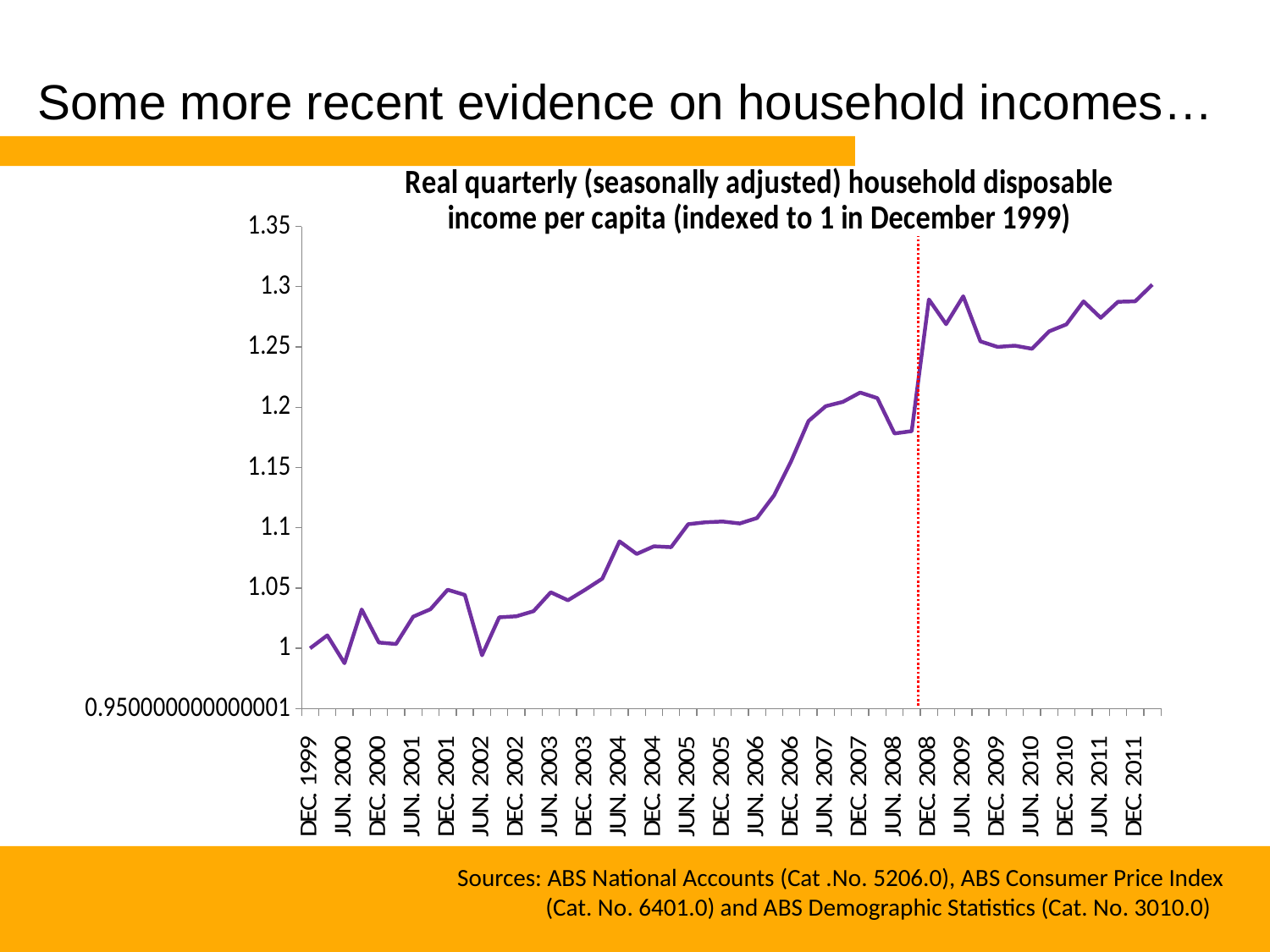
What is the title of the chart? Real quarterly (seasonally adjusted) household disposable income per capita (indexed to 1 in December 1999) What kind of chart is shown on the slide? line chart What is the value of the index in DEC. 1999? 1 Overall, does the index rise or fall from DEC. 1999 to DEC. 2011? rise Is the value for DEC. 2011 greater or less than 1.25? greater How many date labels are shown on the x axis? 25 Is the value for JUN. 2000 greater or less than 1? less Is the value for DEC. 2004 greater or less than 1.1? less Which is larger, the value for JUN. 2009 or the value for JUN. 2010? JUN. 2009